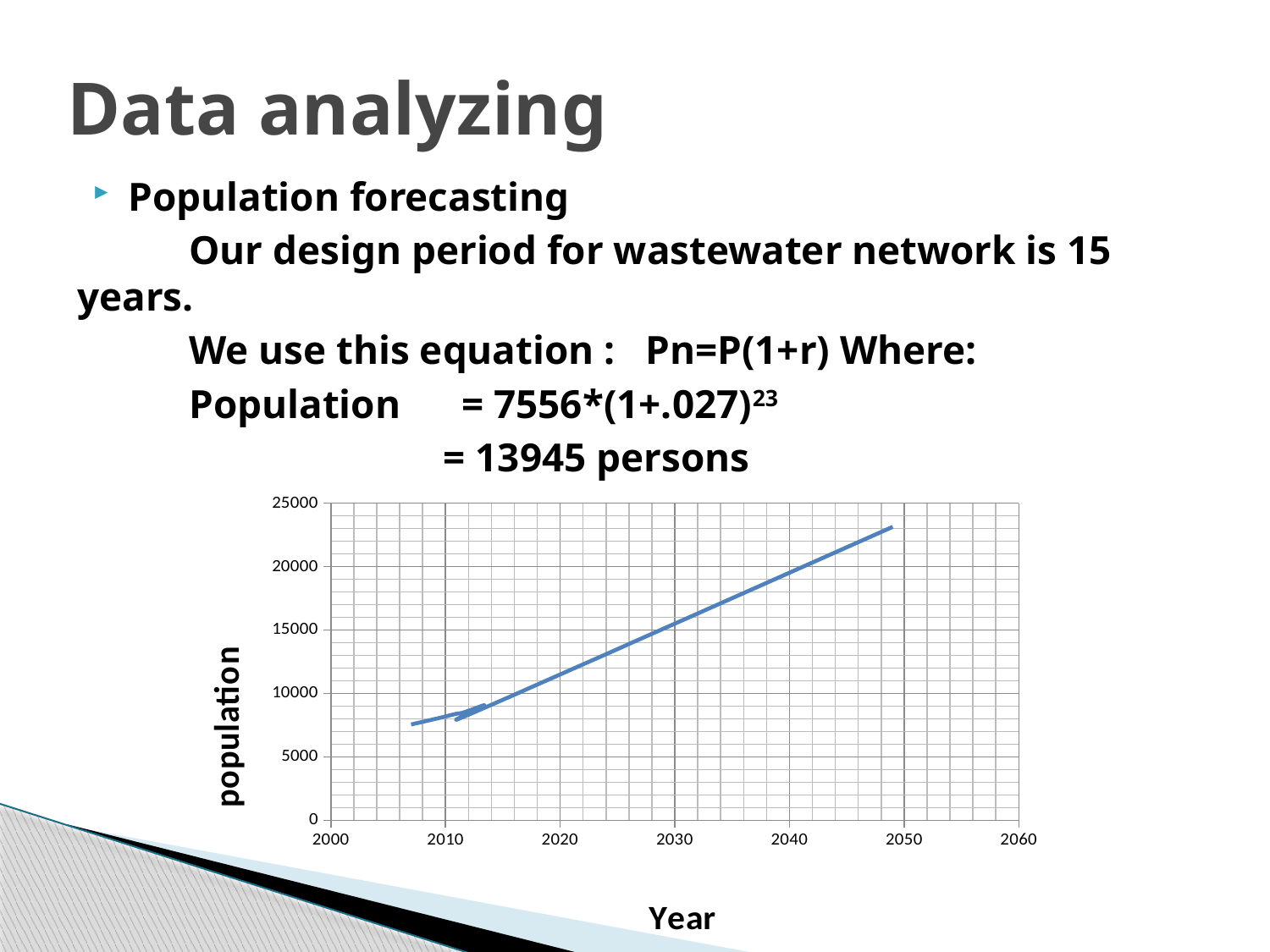
Is the population value plotted at 2010 greater or less than 10000? less Is the population value plotted at 2030 greater or less than 20000? less What is the label of the horizontal axis of the chart? Year Is the highest plotted population value greater or less than 25000? less Does the plotted population rise or fall as the year increases along the x axis? rise What kind of chart is shown on the slide? line chart What is the label of the vertical axis of the chart? population